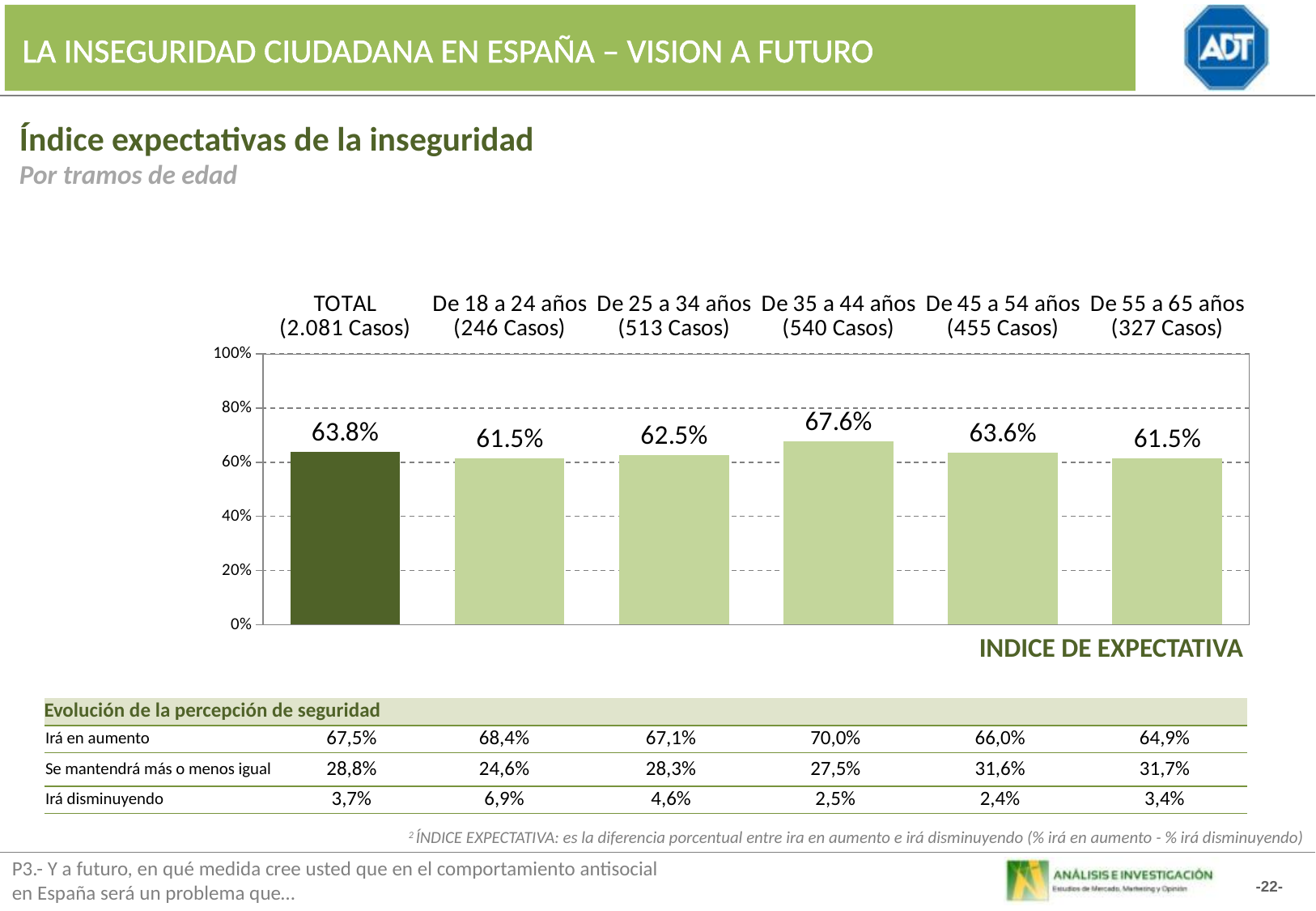
What kind of chart is shown on the slide? Bar chart Which age group has the highest index value in the chart? De 35 a 44 años Is the value for De 55 a 65 años greater or less than 80%? less Which bar is drawn in a darker green than the others? TOTAL How many bars are plotted in the chart? 6 What is the value shown for the TOTAL bar? 63.8% What is the value shown for the De 45 a 54 años group? 63.6% What is the value shown for the De 25 a 34 años group? 62.5% What is the difference between the value for De 35 a 44 años and the value for De 18 a 24 años? 6.1 percentage points What is the value shown for the De 35 a 44 años group? 67.6% What is the difference between the value for De 35 a 44 años and the TOTAL value? 3.8 percentage points Which is larger, the value for De 25 a 34 años or the value for De 45 a 54 años? De 45 a 54 años